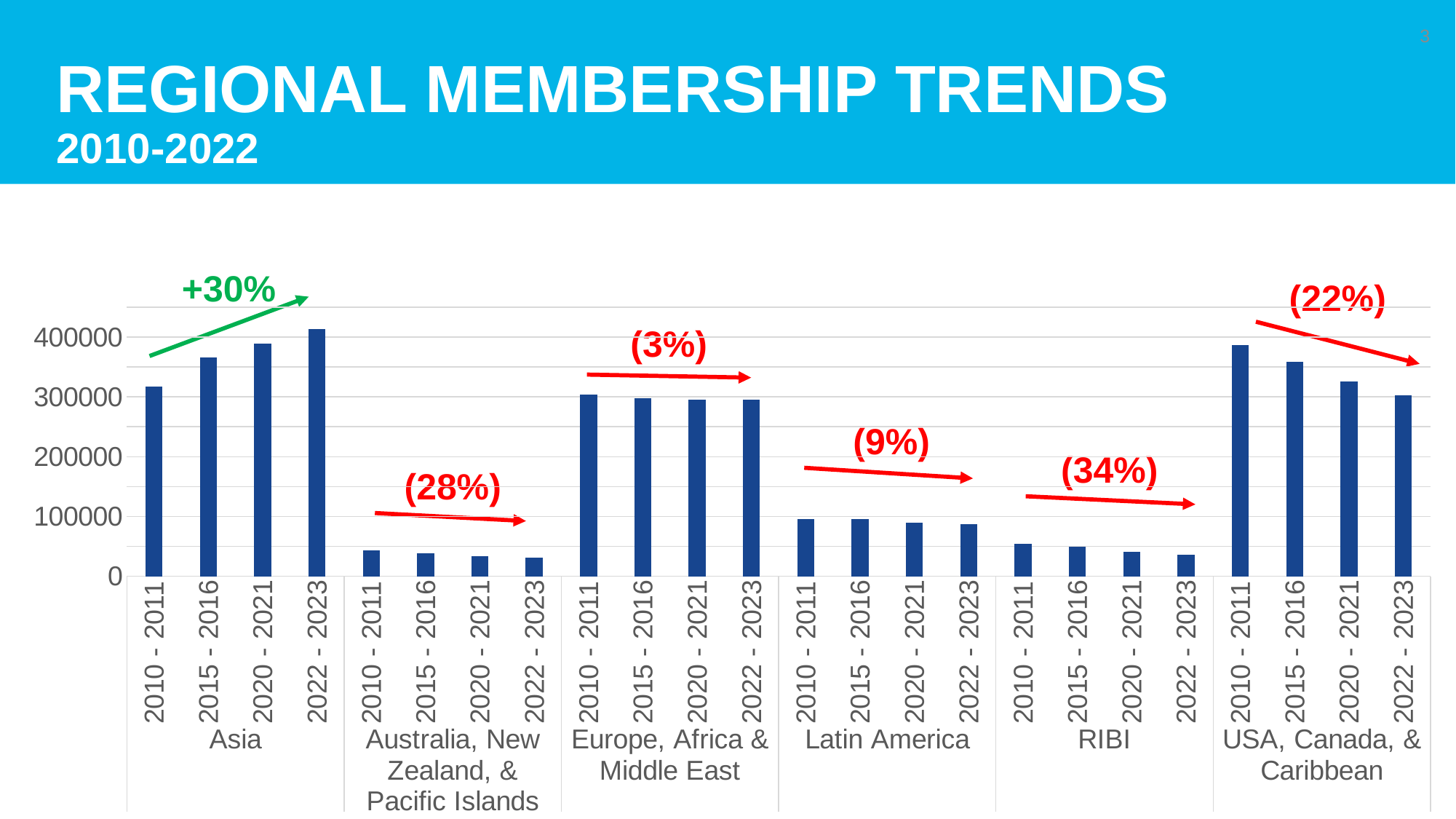
How many regions are shown along the x axis of the chart? 6 What kind of chart is shown on the slide? bar chart What percentage change is annotated above the Europe, Africa & Middle East bars? (3%) What percentage change is annotated above the RIBI bars? (34%) Which is larger: Latin America in 2010 - 2011 or RIBI in 2010 - 2011? Latin America in 2010 - 2011 Do the USA, Canada, & Caribbean bars rise or fall from 2010 - 2011 to 2022 - 2023? fall What percentage change is annotated above the USA, Canada, & Caribbean bars? (22%) How many bars are plotted in the chart in total? 24 Which region has the tallest bar in the chart? Asia What percentage change is annotated above the Asia bars? +30% Is the value for Asia in 2022 - 2023 greater or less than 400000? greater Do the Asia bars rise or fall from 2010 - 2011 to 2022 - 2023? rise